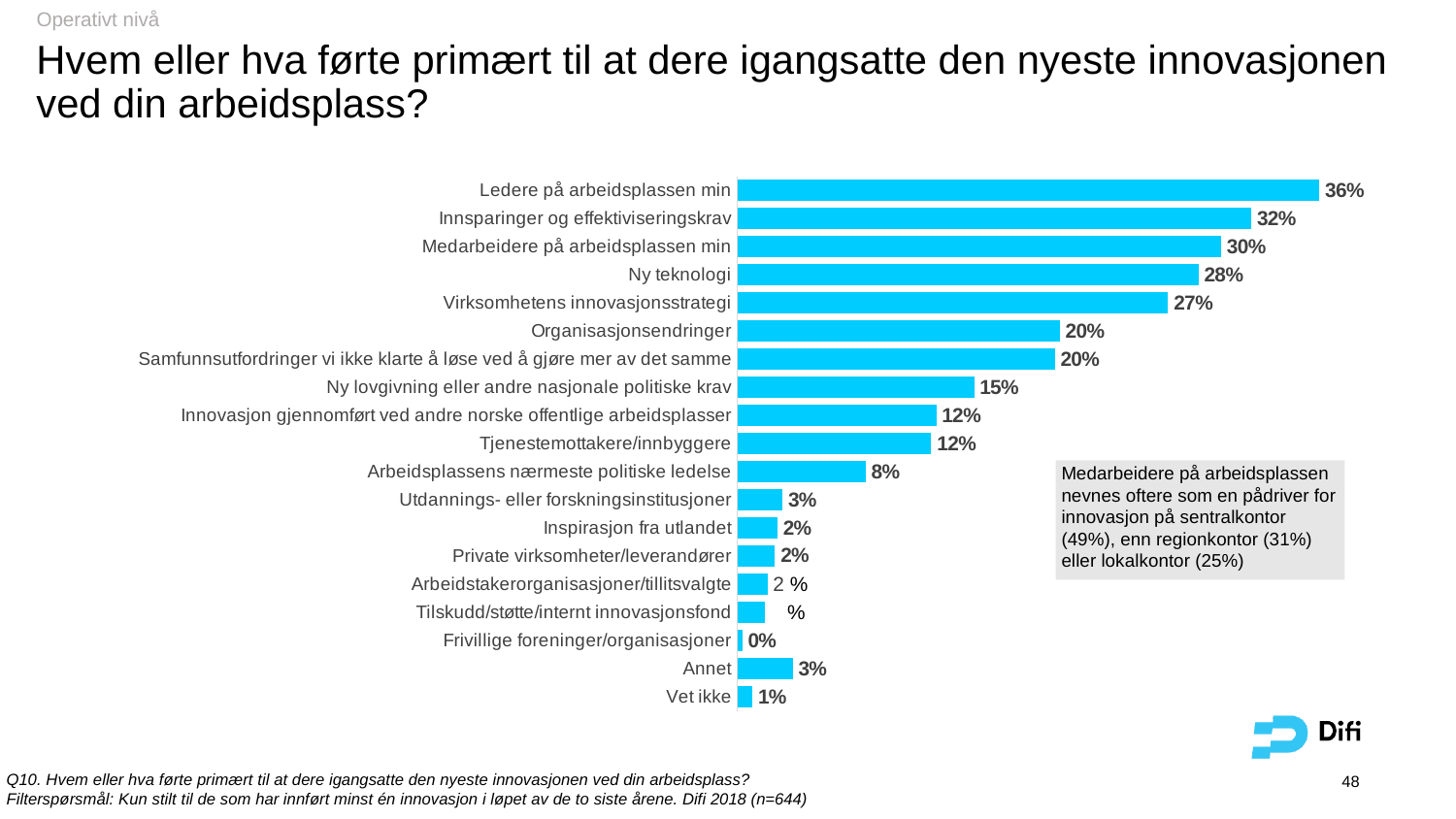
What is the value for "Ny teknologi"? 28% What is the value for "Vet ikke"? 1% Which category has the lowest value? Frivillige foreninger/organisasjoner What is the difference between "Medarbeidere på arbeidsplassen min" and "Organisasjonsendringer"? 10% What is the value for "Ledere på arbeidsplassen min"? 36% Which is larger: "Virksomhetens innovasjonsstrategi" or "Tjenestemottakere/innbyggere"? Virksomhetens innovasjonsstrategi What is the value for "Arbeidsplassens nærmeste politiske ledelse"? 8% What is the difference between "Innsparinger og effektiviseringskrav" and "Ny lovgivning eller andre nasjonale politiske krav"? 17% Which category has the highest value? Ledere på arbeidsplassen min How many categories are shown in the chart? 19 What kind of chart is shown on the slide? Bar chart What colour are the bars in the chart? Light blue